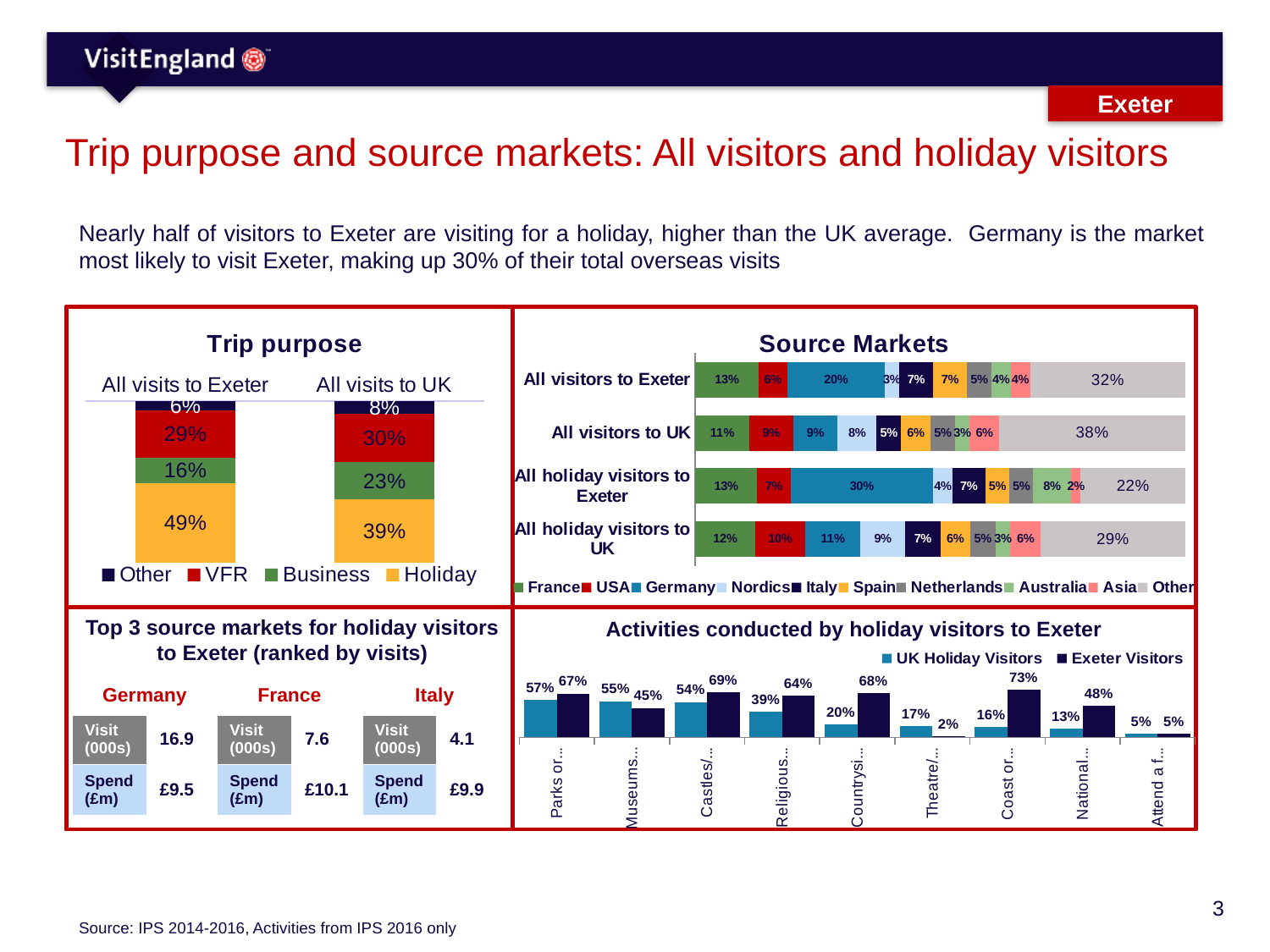
What kind of chart is the Activities conducted by holiday visitors to Exeter chart? Bar chart In the Activities conducted by holiday visitors to Exeter chart, what is the difference between Exeter Visitors and UK Holiday Visitors for the category beginning 'Countrysi'? 48 percentage points In the Activities conducted by holiday visitors to Exeter chart, what is the Exeter Visitors value for the category beginning 'Coast'? 73% In the Trip purpose chart, how many series does the legend list? 4 In the Source Markets chart, what share of all holiday visitors to Exeter come from Germany? 30% In the Activities conducted by holiday visitors to Exeter chart, which is larger for the category beginning 'Museums': UK Holiday Visitors or Exeter Visitors? UK Holiday Visitors In the Trip purpose chart, what is the difference between the holiday share for all visits to Exeter and for all visits to the UK? 10 percentage points In the Source Markets chart, which bar has the largest 'Other' segment? All visitors to UK In the Source Markets chart, what share of all visitors to Exeter come from France? 13% In the Trip purpose chart, what share of all visits to the UK are for business? 23% In the Trip purpose chart, what share of all visits to Exeter are for a holiday? 49% In the Source Markets chart, how many source markets does the legend list? 10